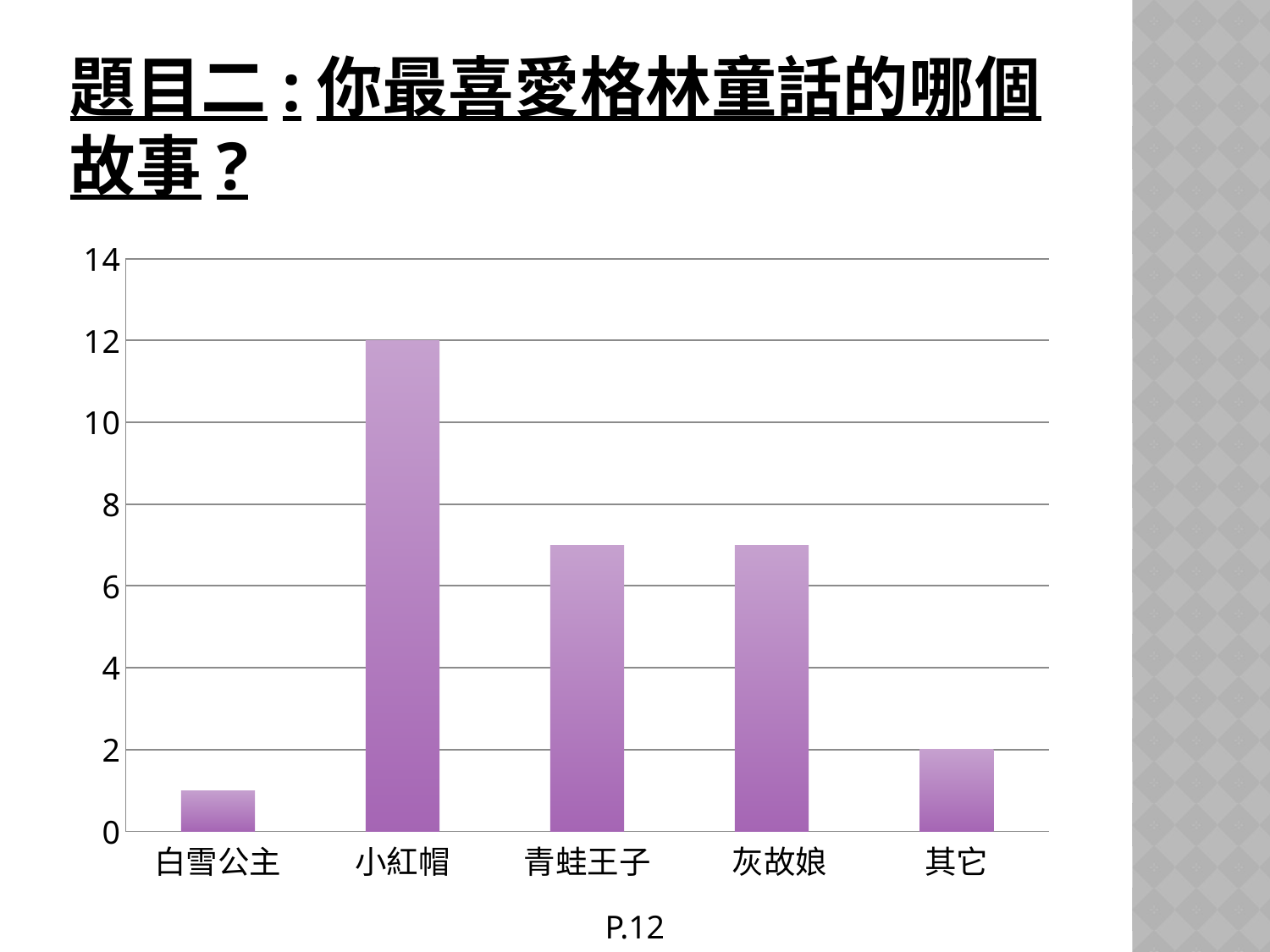
What is the difference between the values for 小紅帽 and 其它? 10 What is the value for 小紅帽? 12 Which category has the lowest value? 白雪公主 Which is larger, the value for 其它 or the value for 灰故娘? 灰故娘 Is the value for 白雪公主 greater or less than 2? less Which category has the highest value? 小紅帽 What kind of chart is shown on the slide? bar chart Is the value for 灰故娘 greater or less than 8? less Is the value for 青蛙王子 greater or less than 6? greater Which is larger, the value for 小紅帽 or the value for 青蛙王子? 小紅帽 What is the value for 其它? 2 How many categories are shown on the x axis? 5